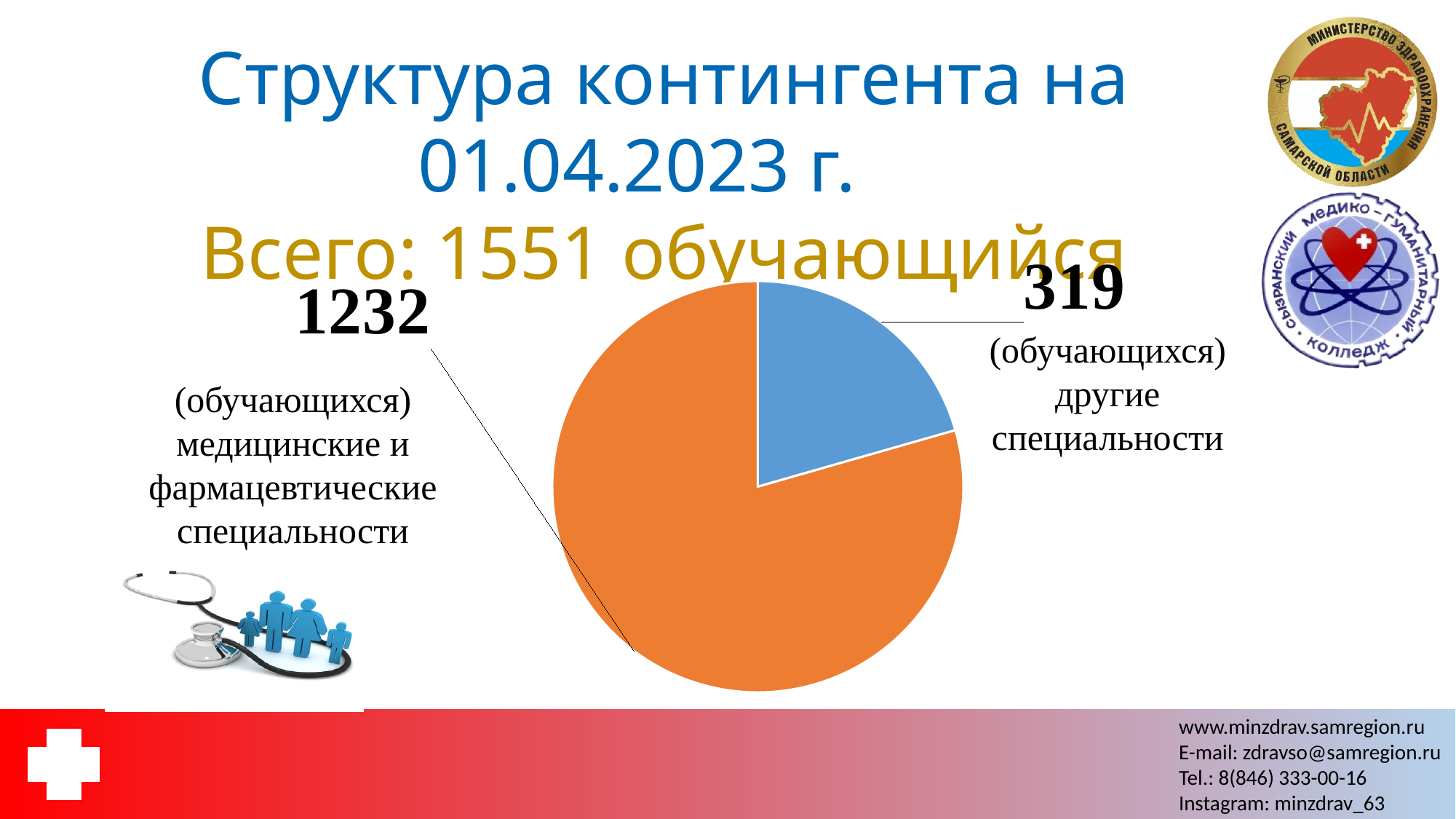
What is the total number of students shown on the slide? 1551 What colour is the slice for other specialties (другие специальности)? blue How many students are in other specialties (другие специальности)? 319 Which category has the largest slice of the pie? медицинские и фармацевтические специальности What is the difference between the number of students in medical and pharmaceutical specialties and the number in other specialties? 913 What colour is the slice for medical and pharmaceutical specialties? orange Which is larger: the number of students in medical and pharmaceutical specialties or in other specialties? медицинские и фармацевтические специальности What date is given in the slide title for the contingent structure? 01.04.2023 What kind of chart is shown on the slide? pie chart How many students are in medical and pharmaceutical specialties (медицинские и фармацевтические специальности)? 1232 How many slices does the pie chart have? 2 Which category has the smallest slice of the pie? другие специальности